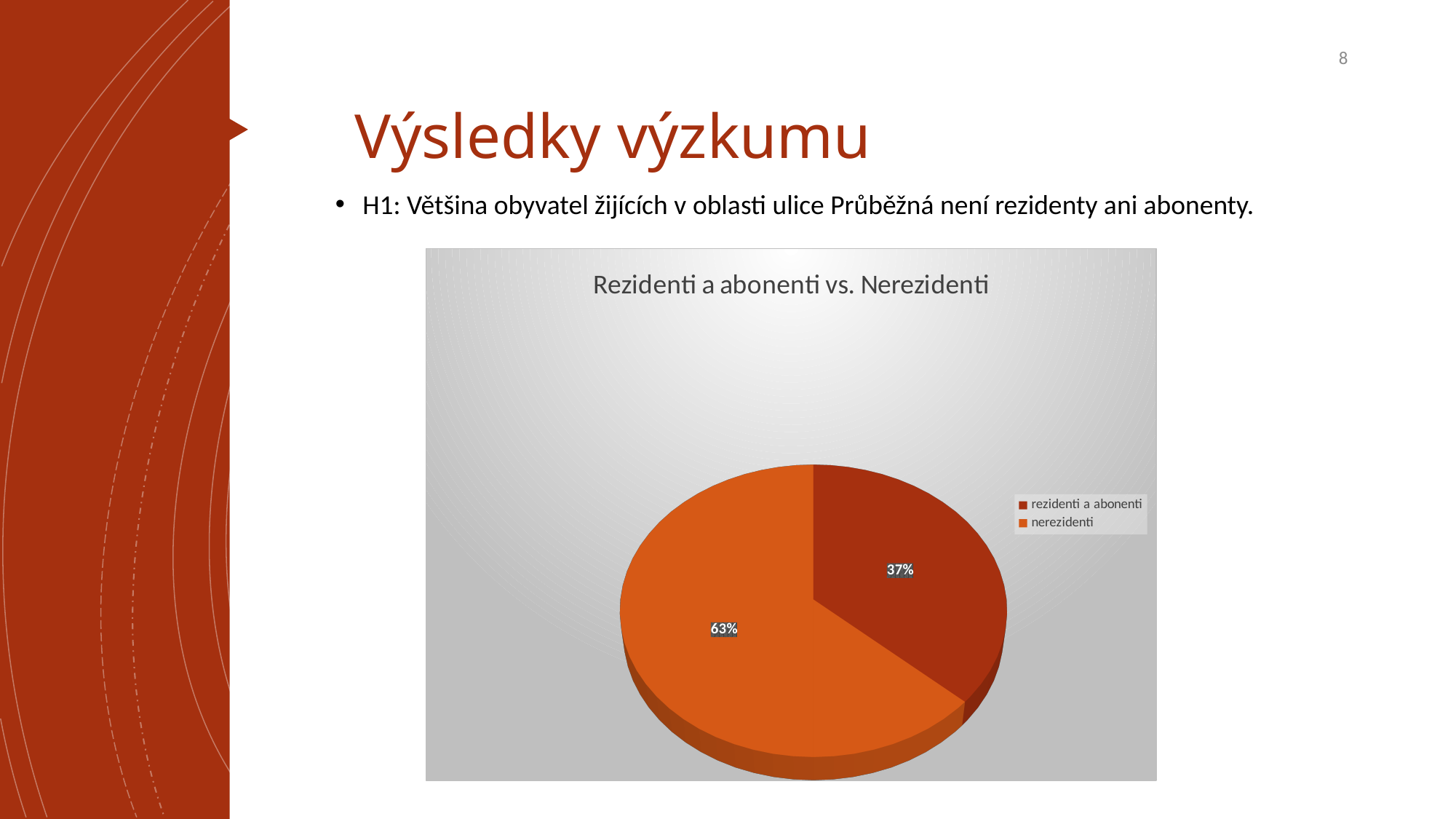
What is the difference in percentage points between the 'nerezidenti' and 'rezidenti a abonenti' slices? 26 What is the title of the chart? Rezidenti a abonenti vs. Nerezidenti Which category has the largest slice of the pie? nerezidenti What kind of chart is shown on the slide? pie chart How many slices does the pie chart have? 2 Which category has the smallest slice of the pie? rezidenti a abonenti Which legend entry is shown in the darker red colour? rezidenti a abonenti Which is larger, the 'rezidenti a abonenti' slice or the 'nerezidenti' slice? nerezidenti What share of the pie is labelled for 'rezidenti a abonenti'? 37% How many entries does the legend list? 2 Is the share for 'rezidenti a abonenti' greater or less than 50%? less What share of the pie is labelled for 'nerezidenti'? 63%